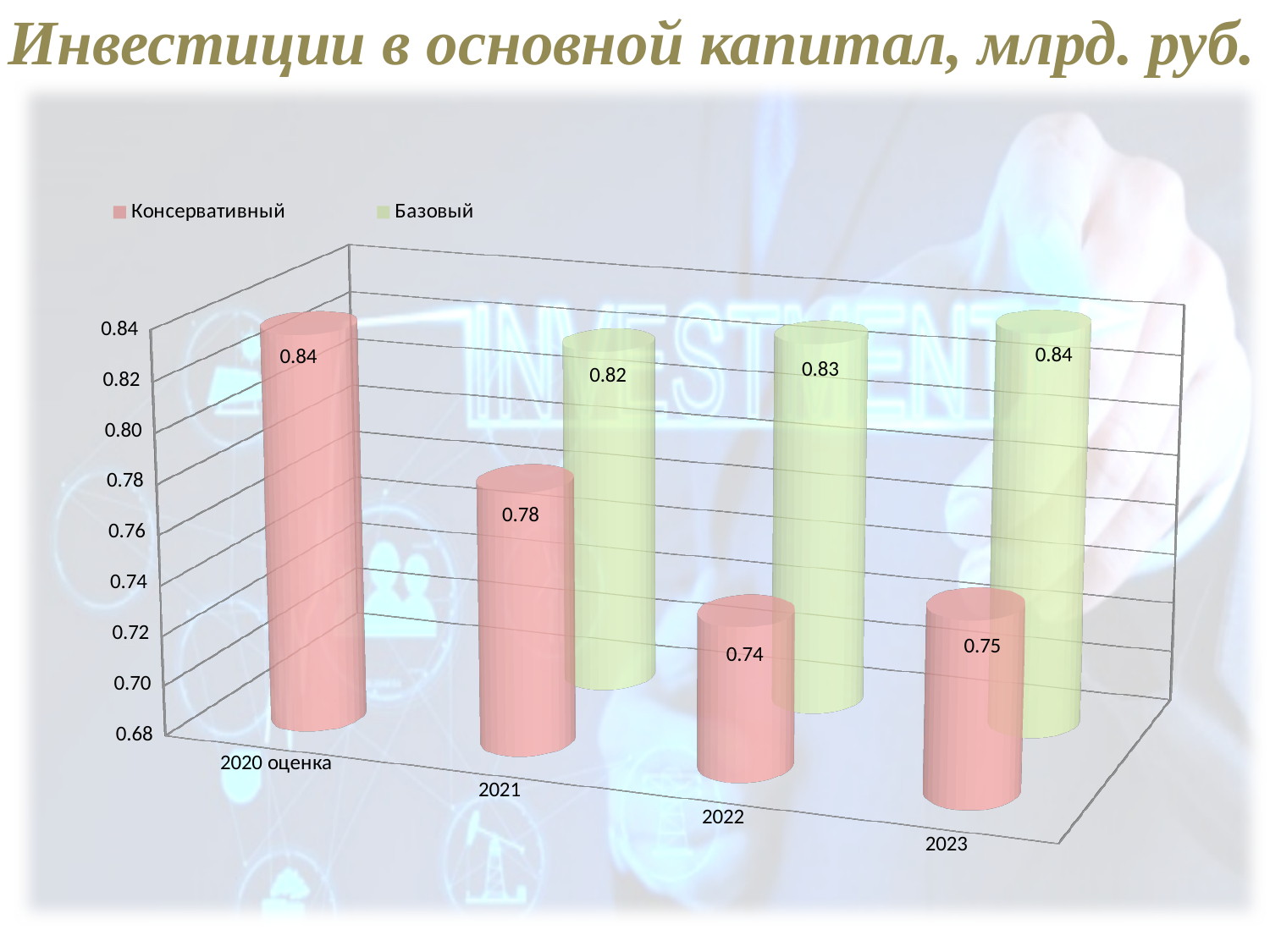
In which year is the Базовый series highest? 2023 How many series does the legend list? 2 Which series has the larger value in 2023, Консервативный or Базовый? Базовый What is the value for Консервативный in 2023? 0.75 What is the title of the chart? Инвестиции в основной капитал, млрд. руб. Does the Базовый series rise or fall from 2021 to 2023? Rise How many categories are shown on the x axis? 4 What kind of chart is shown on the slide? Bar chart What is the value for Базовый in 2022? 0.83 What is the value for Консервативный in 2021? 0.78 In which year is the Консервативный series lowest? 2022 What is the difference between the Базовый and Консервативный values in 2022? 0.09